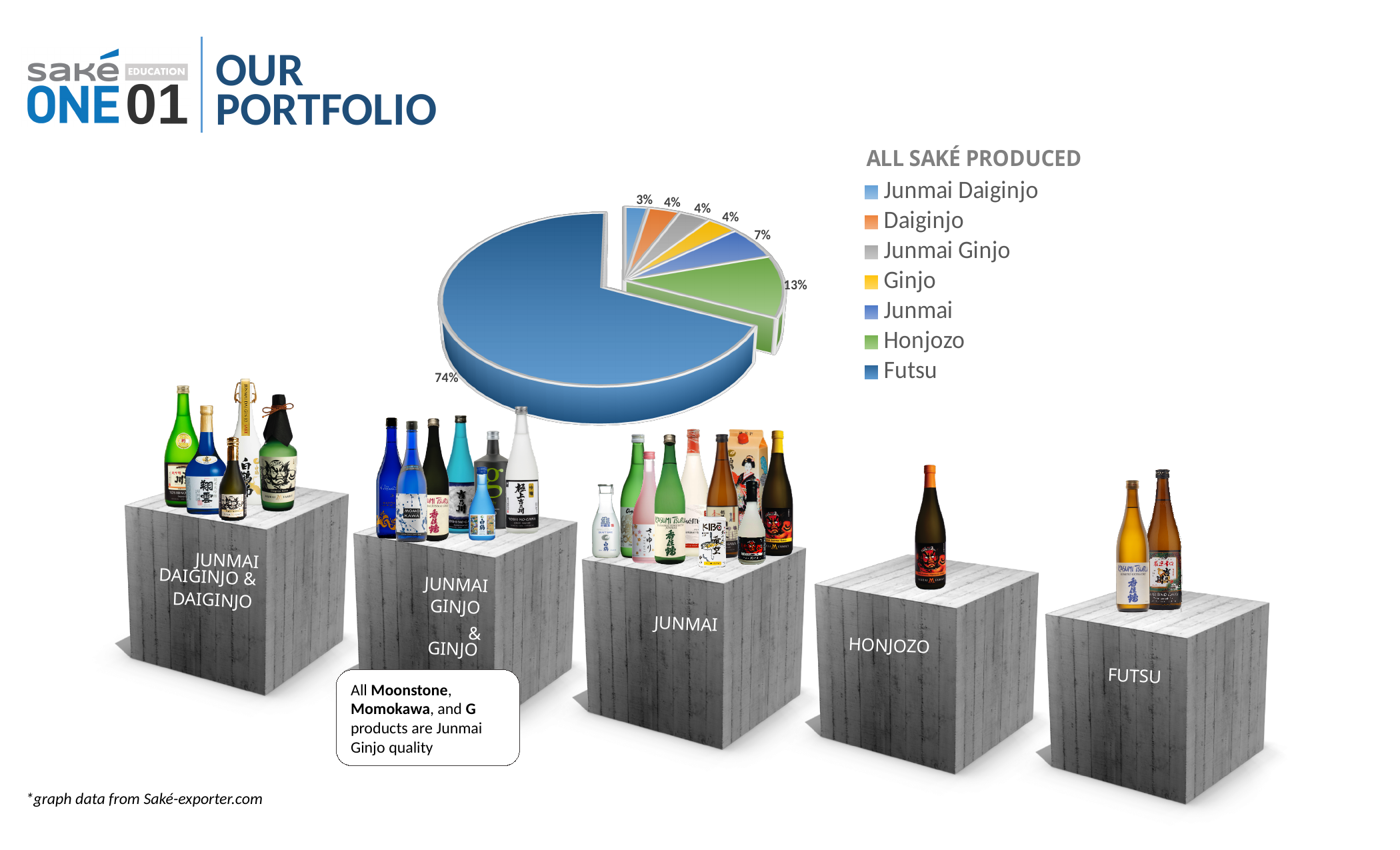
What share of all saké produced is Honjozo? 13% What share of all saké produced is Junmai Daiginjo? 3% What is the title of the chart? ALL SAKÉ PRODUCED How many categories does the legend of the pie chart list? 7 What type of chart is shown on the slide? pie chart Which slice is larger, Honjozo or Junmai? Honjozo What share of all saké produced is Futsu? 74% What share of all saké produced is Junmai? 7% Which category has the largest slice of the pie chart? Futsu Which legend entry is shown in green? Honjozo Which category has the smallest slice of the pie chart? Junmai Daiginjo What is the difference in percentage points between the Futsu and Honjozo slices? 61